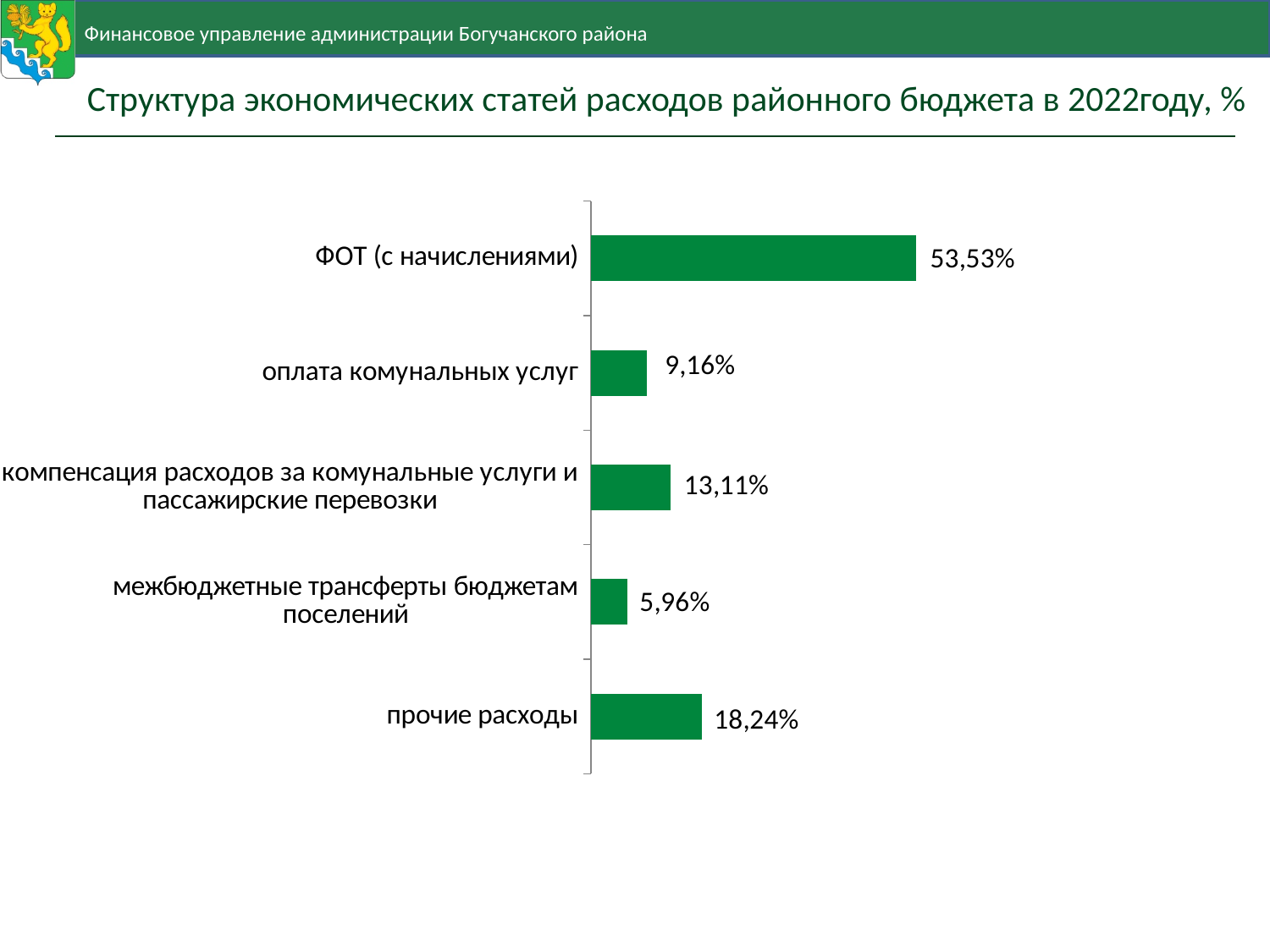
What is the value for оплата комунальных услуг? 9,16% What is the value for межбюджетные трансферты бюджетам поселений? 5,96% What is the difference between the values for ФОТ (с начислениями) and прочие расходы? 35,29% What is the value for ФОТ (с начислениями)? 53,53% Which is larger: the value for прочие расходы or the value for компенсация расходов за комунальные услуги и пассажирские перевозки? прочие расходы What is the difference between the values for компенсация расходов за комунальные услуги и пассажирские перевозки and оплата комунальных услуг? 3,95% Which category has the highest value? ФОТ (с начислениями) How many categories are shown in the chart? 5 What kind of chart is shown on the slide? bar chart What is the value for прочие расходы? 18,24% What is the value for компенсация расходов за комунальные услуги и пассажирские перевозки? 13,11% Which category has the lowest value? межбюджетные трансферты бюджетам поселений